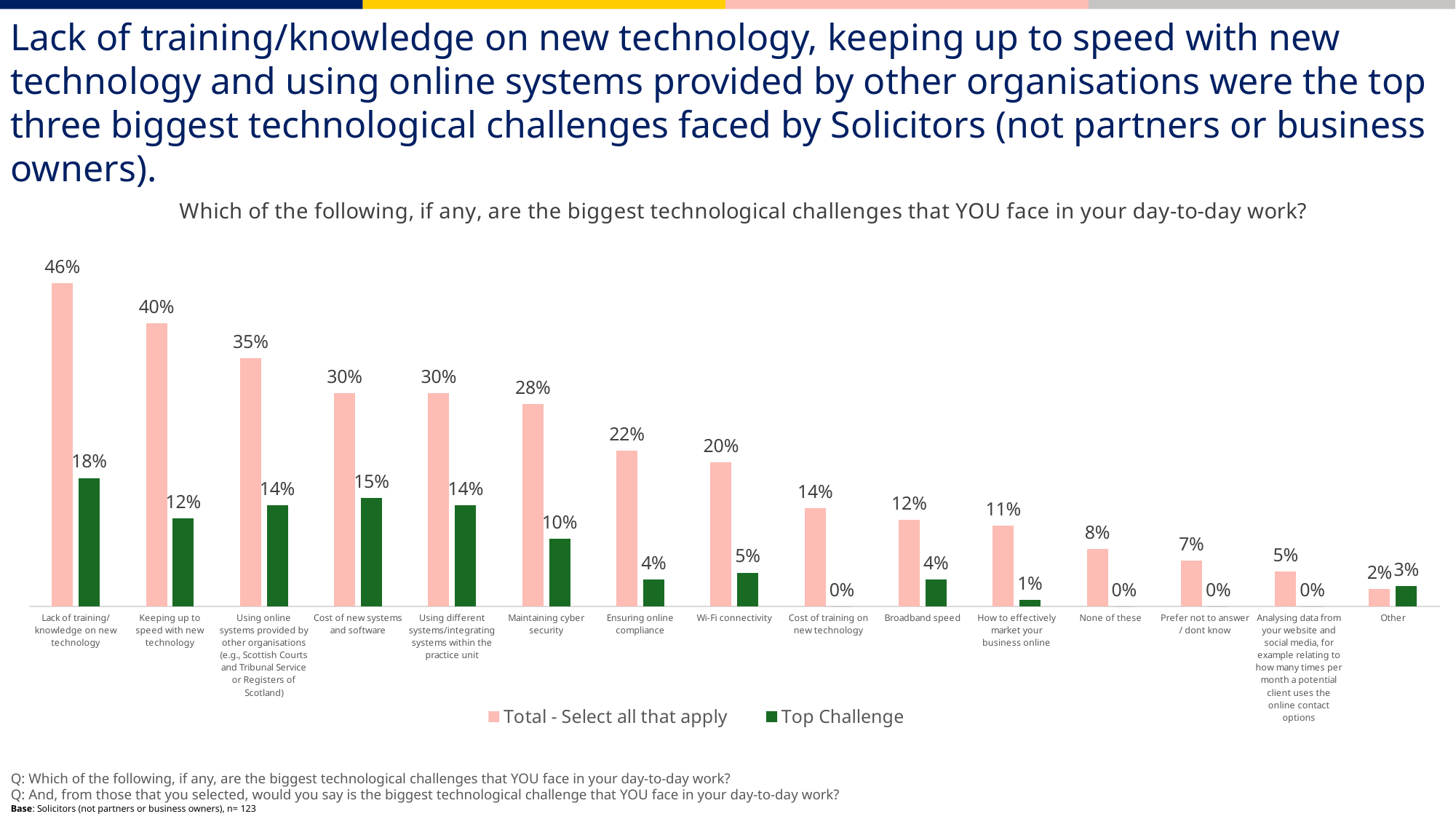
What colour are the 'Top Challenge' bars? Dark green Which category has the highest 'Top Challenge' value? Lack of training/knowledge on new technology What is the 'Total - Select all that apply' value for Lack of training/knowledge on new technology? 46% Which category has the lowest 'Total - Select all that apply' value? Other How many series does the legend list? 2 Which is larger: the 'Top Challenge' value for Ensuring online compliance or for Wi-Fi connectivity? Wi-Fi connectivity Do the 'Total - Select all that apply' values generally rise or fall from left to right along the x axis? Fall What kind of chart is shown on the slide? Bar chart How many categories are shown on the x axis of the chart? 15 What is the difference between the 'Total - Select all that apply' values for Keeping up to speed with new technology and Maintaining cyber security? 12% What is the 'Top Challenge' value for Cost of new systems and software? 15% What is the 'Total - Select all that apply' value for Wi-Fi connectivity? 20%